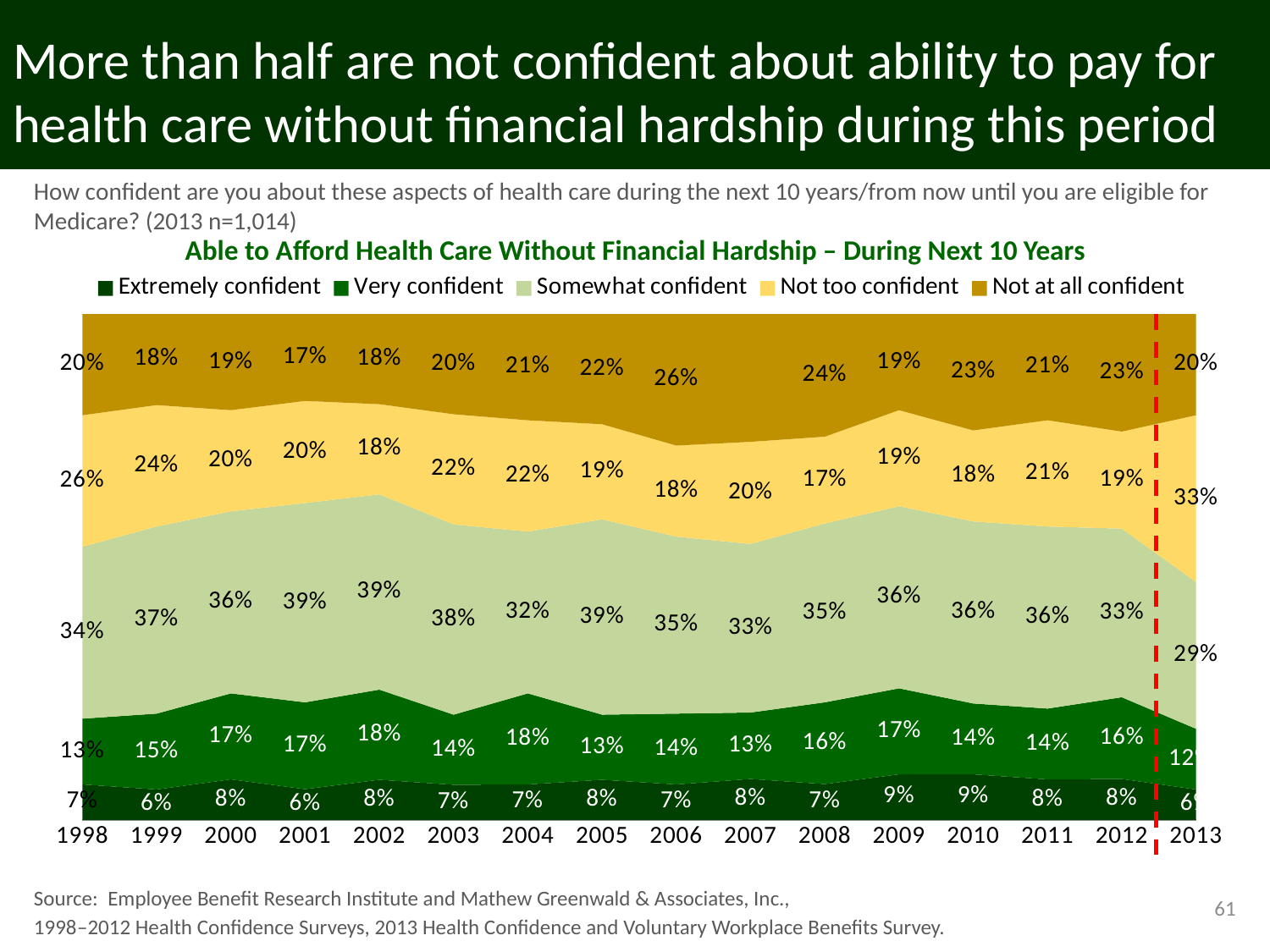
What percentage were "Somewhat confident" in 2002? 39% How many series does the legend list? 5 What percentage were "Not too confident" in 2013? 33% Which was larger in 2010: the "Not at all confident" share or the "Not too confident" share? Not at all confident What percentage were "Not at all confident" in 2006? 26% What is the difference between the "Very confident" share in 2002 and in 2005? 5 percentage points In which year was the "Somewhat confident" share lowest? 2013 What kind of chart is shown on the slide? Stacked area chart What is the title of the chart? Able to Afford Health Care Without Financial Hardship – During Next 10 Years In which year was the "Not too confident" share highest? 2013 What percentage were "Extremely confident" in 2009? 9% How many years are shown along the x axis? 16